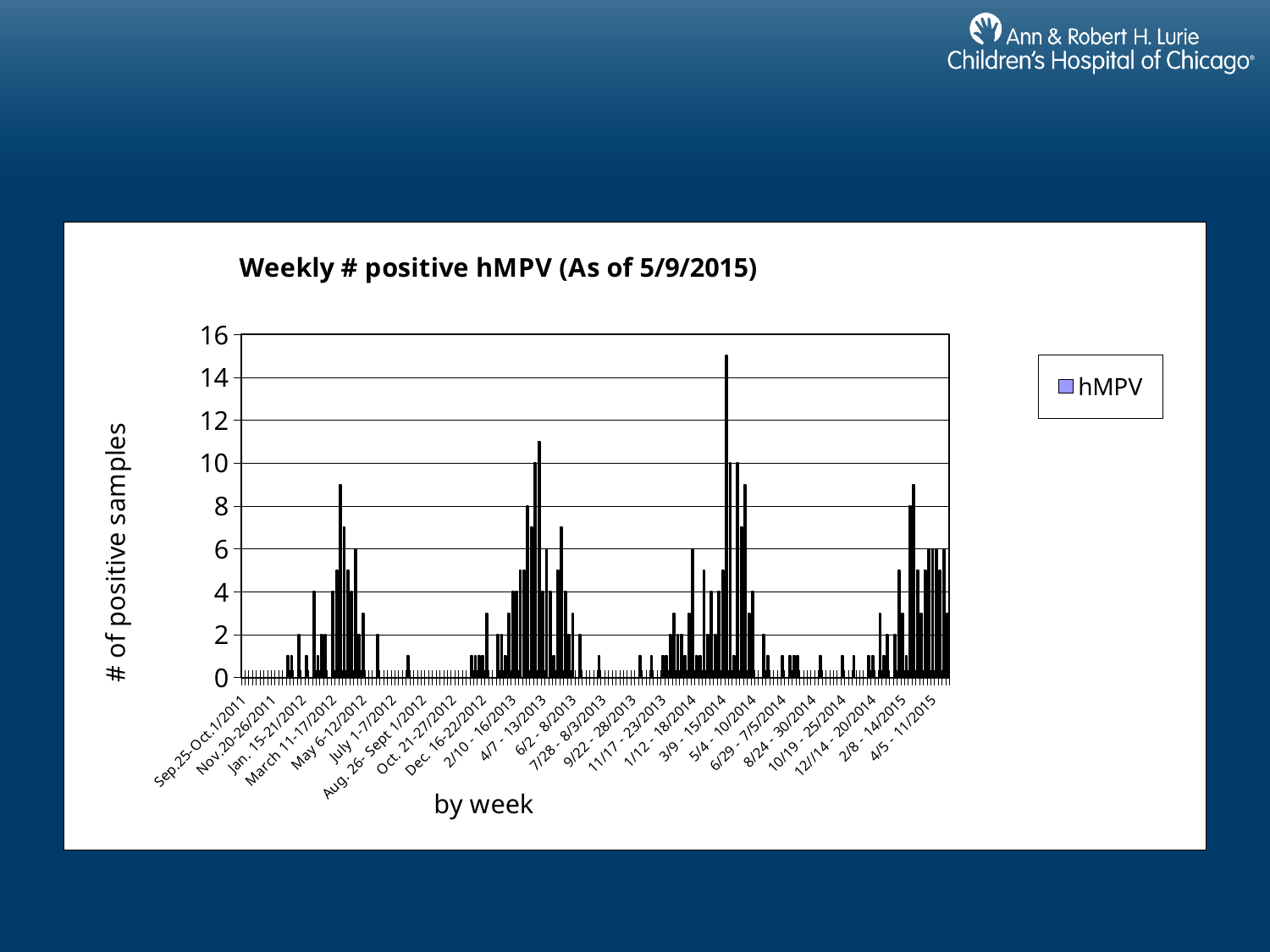
Is the tallest bar in the chart greater or less than 14? greater What is the label on the vertical axis of the chart? # of positive samples How many series does the legend list? 1 Is the highest weekly value in the early 2013 season (around 4/7 - 13/2013) greater or less than 10? greater Which season has the higher peak of positive hMPV samples: spring 2012 or spring 2013? spring 2013 What is the title of the chart? Weekly # positive hMPV (As of 5/9/2015) What is the highest value shown on the vertical axis? 16 Do the weekly values rise steadily, fall steadily, or show repeated seasonal peaks across the x axis? repeated seasonal peaks What kind of chart is shown on the slide? bar chart Is the highest weekly value in the spring 2012 season (around March-May 2012) greater or less than 10? less Which season has the higher peak of positive hMPV samples: early 2013 or early 2014? early 2014